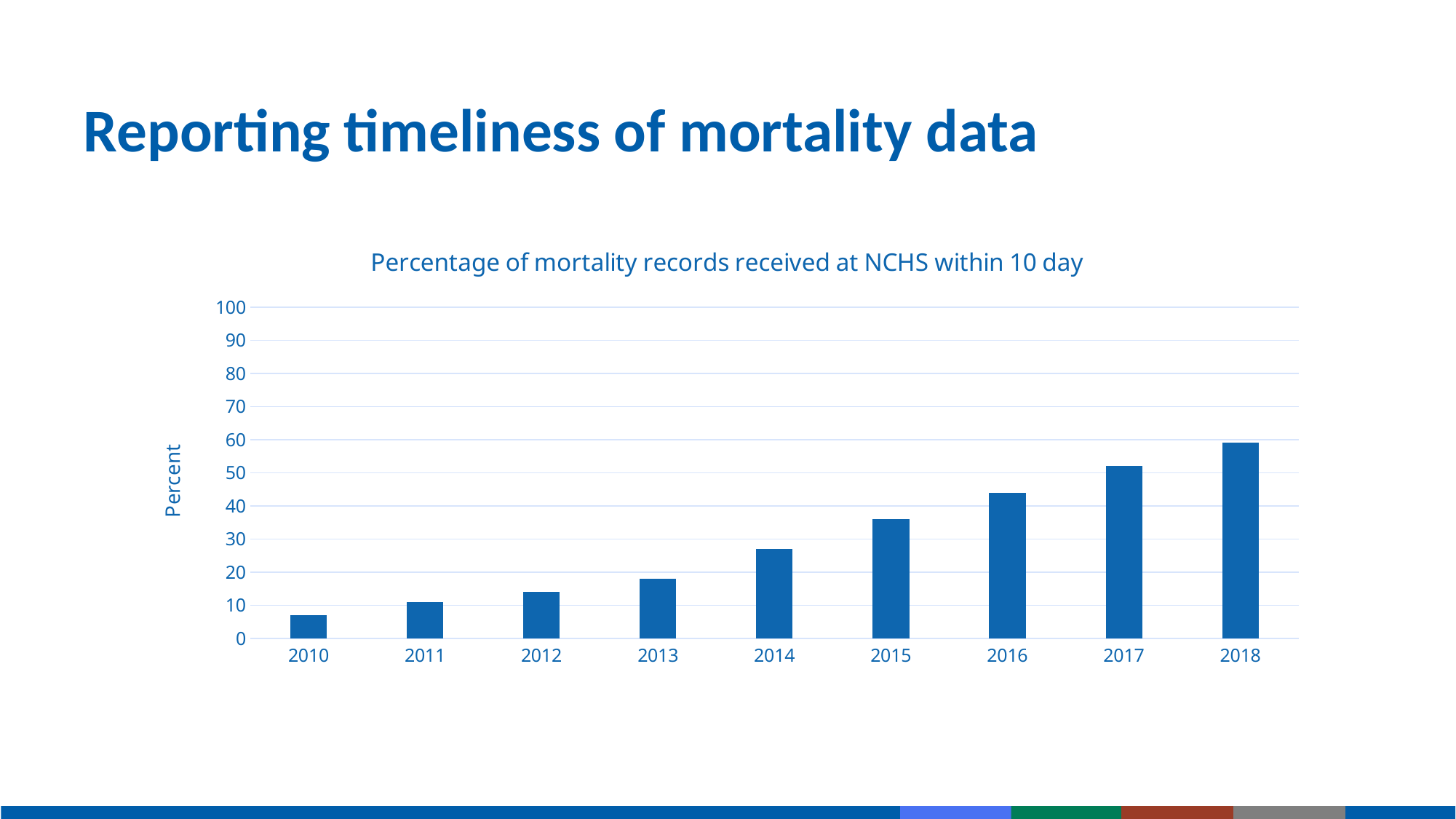
Is the value for 2017 greater or less than 40? greater Which year has the highest percentage of mortality records received within 10 days? 2018 Is the value for 2018 greater or less than 50? greater What kind of chart is shown on the slide? bar chart How many years are shown on the x axis of the chart? 9 What is the label on the vertical axis of the chart? Percent Do the values rise or fall from 2010 to 2018? rise Is the value for 2010 greater or less than 10? less Which year has a larger value, 2015 or 2017? 2017 Which year has the lowest percentage of mortality records received within 10 days? 2010 What is the title of the chart? Percentage of mortality records received at NCHS within 10 day